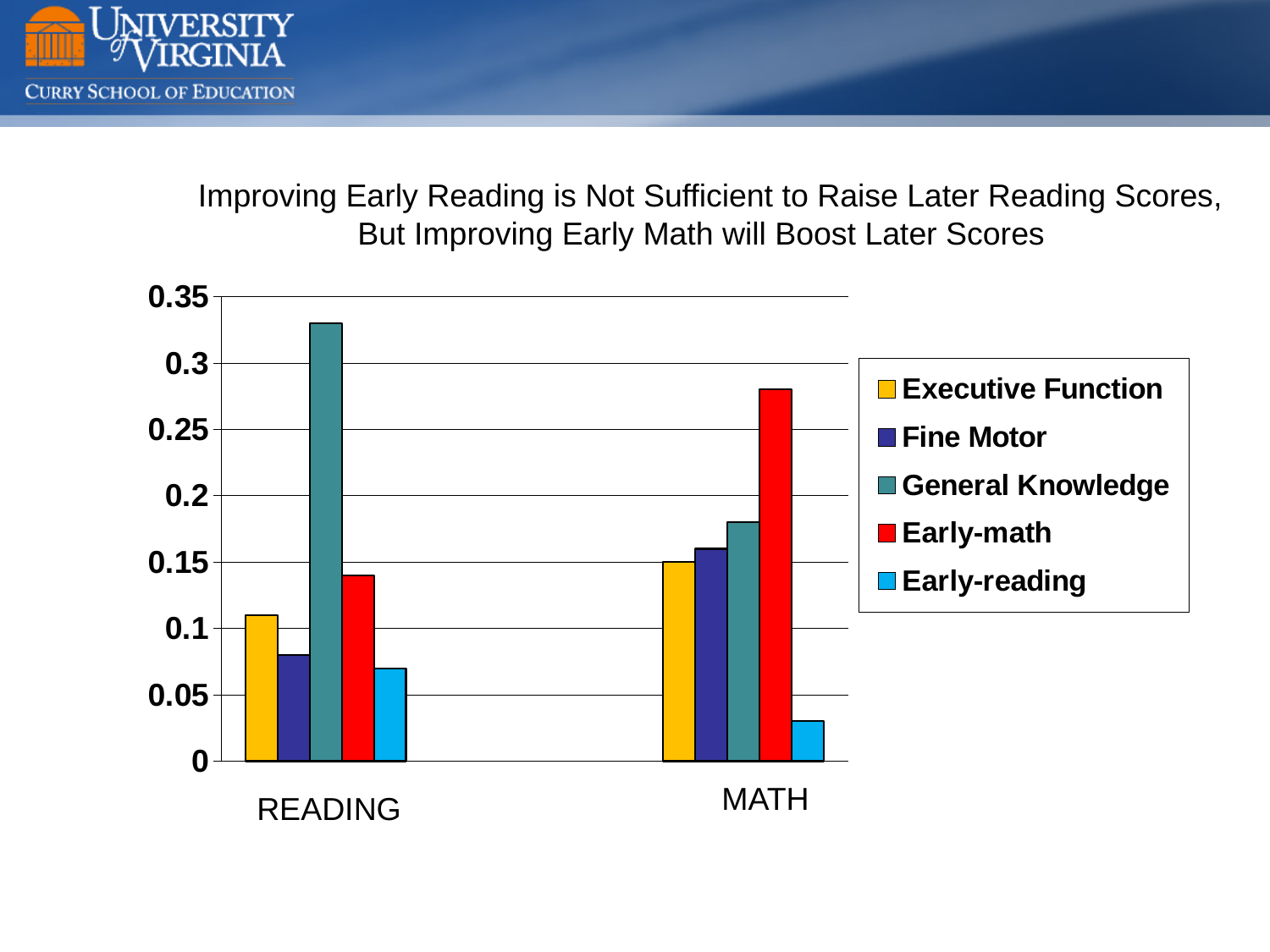
How many series does the legend list? 5 Is the value for Early-math in MATH greater or less than 0.25? greater How many categories are shown on the x axis? 2 What kind of chart is shown on the slide? bar chart Which series has the highest value for READING? General Knowledge Which is larger: the Early-math value for READING or the Early-math value for MATH? MATH Is the value for Fine Motor in READING greater or less than 0.1? less Is the value for Early-reading in MATH greater or less than 0.05? less What colour are the Early-math bars? red Which series has the highest value for MATH? Early-math Which series has the lowest value for MATH? Early-reading